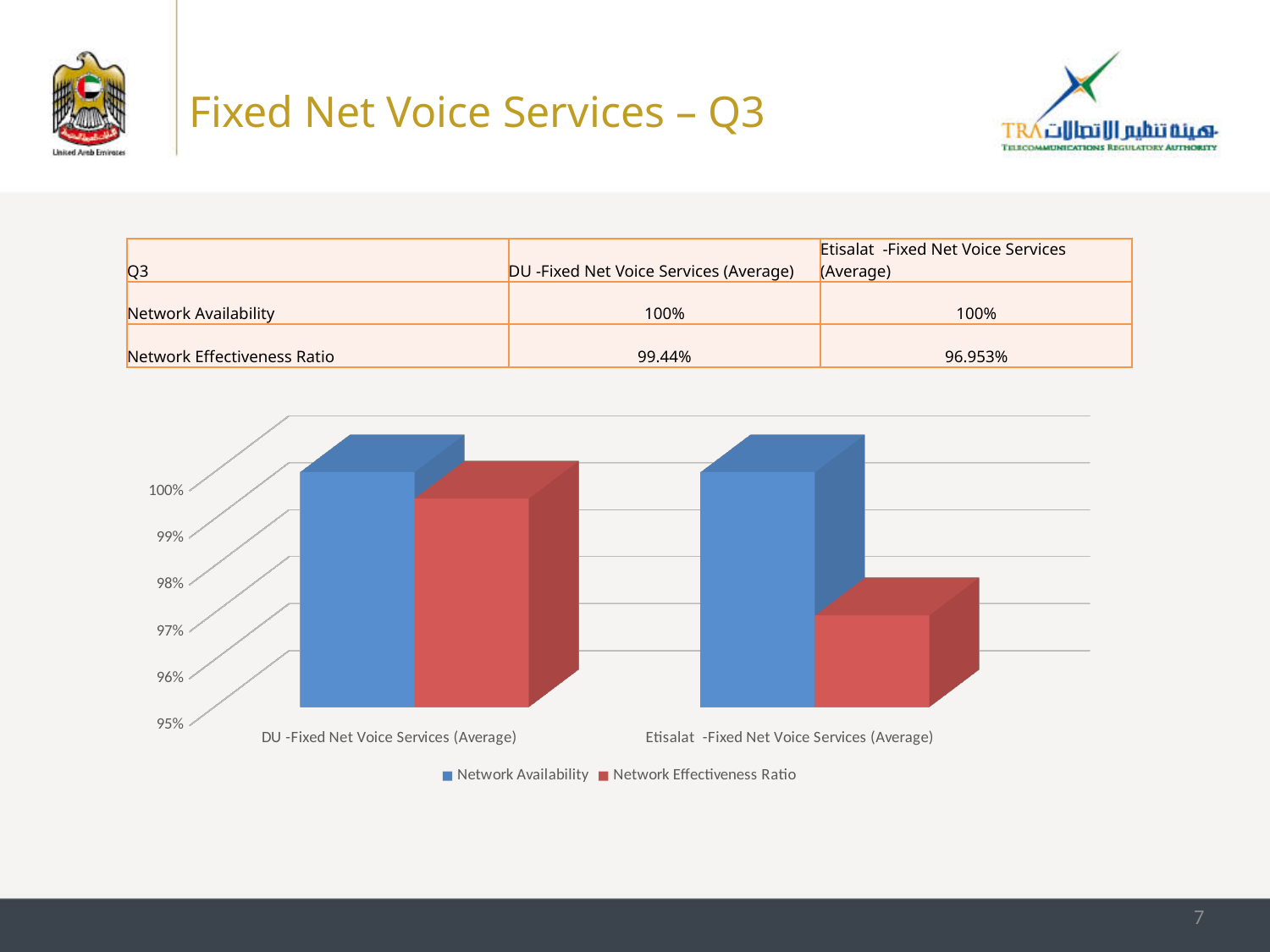
What kind of chart is shown on the slide? bar chart Which is larger, the Network Effectiveness Ratio for DU or for Etisalat? DU Which operator has the lower Network Effectiveness Ratio? Etisalat - Fixed Net Voice Services (Average) What is the Network Availability value for Etisalat - Fixed Net Voice Services (Average)? 100% What is the Network Effectiveness Ratio for Etisalat - Fixed Net Voice Services (Average)? 96.953% What is the difference between the Network Effectiveness Ratio for DU and for Etisalat? 2.487% What is the Network Availability value for DU - Fixed Net Voice Services (Average)? 100% How many operator categories are shown on the x axis of the chart? 2 Is the Network Effectiveness Ratio for Etisalat greater or less than 98%? less What is the Network Effectiveness Ratio for DU - Fixed Net Voice Services (Average)? 99.44% How many series does the chart legend list? 2 What is the difference between Network Availability and Network Effectiveness Ratio for Etisalat? 3.047%